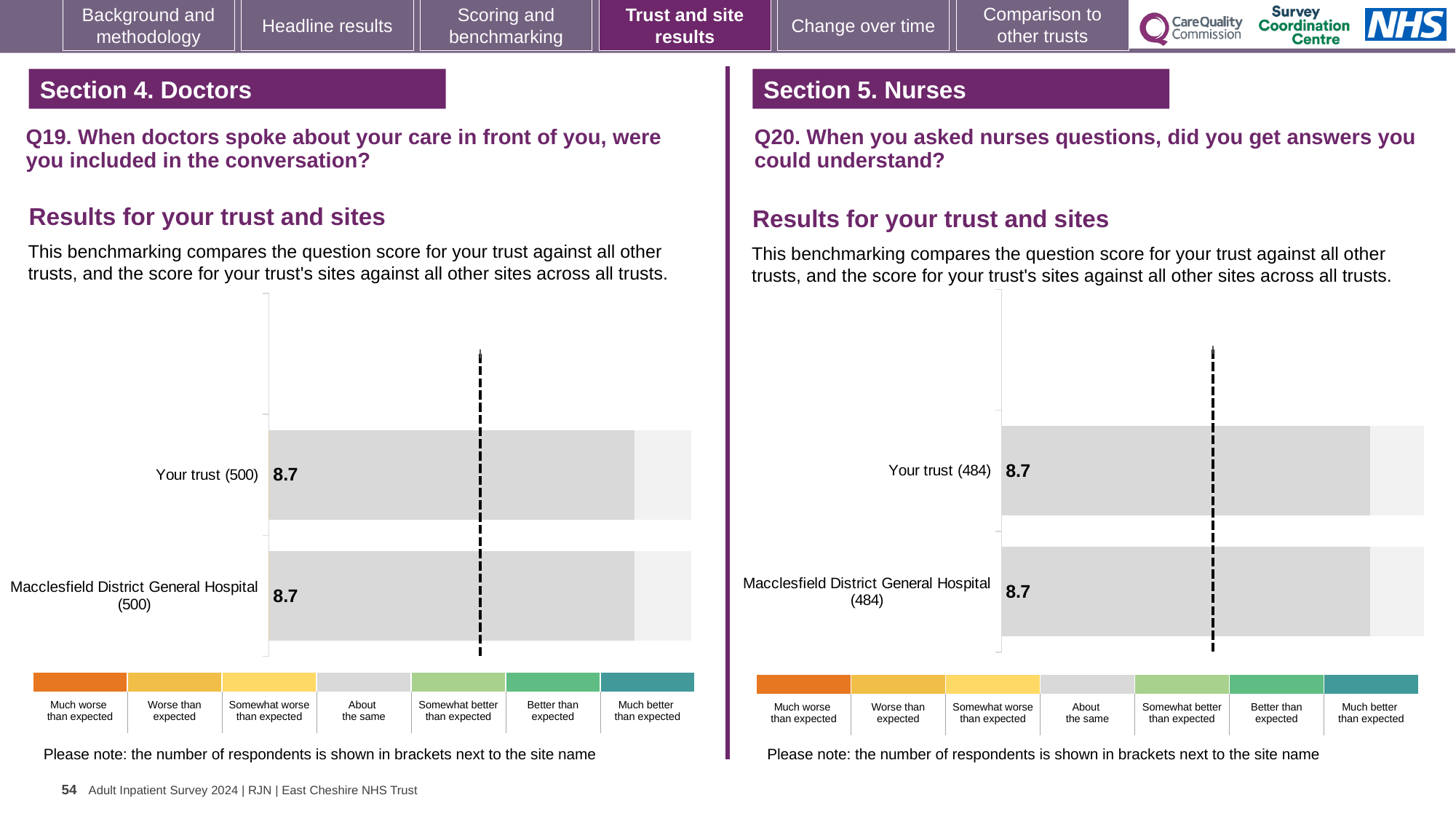
In the Q19 chart on the left, what is the score for Your trust? 8.7 In the Q20 chart on the right, what is the score for Macclesfield District General Hospital? 8.7 What type of chart is used in the Q19 chart on the left? Bar chart In the Q20 chart on the right, how many categories are shown? 2 In the Q20 chart on the right, how many respondents are shown in brackets for Macclesfield District General Hospital? 484 How many benchmark categories are listed in the colour legend below the Q19 chart on the left? 7 In the Q20 chart on the right, what is the score for Your trust? 8.7 In the Q19 chart on the left, how many respondents are shown in brackets for Your trust? 500 In the Q19 chart on the left, what is the difference between the score for Your trust and the score for Macclesfield District General Hospital? 0 In the Q20 chart on the right, which benchmark category does the grey colour of the bars correspond to in the legend? About the same In the Q19 chart on the left, how many bars are plotted? 2 In the Q19 chart on the left, what is the score for Macclesfield District General Hospital? 8.7